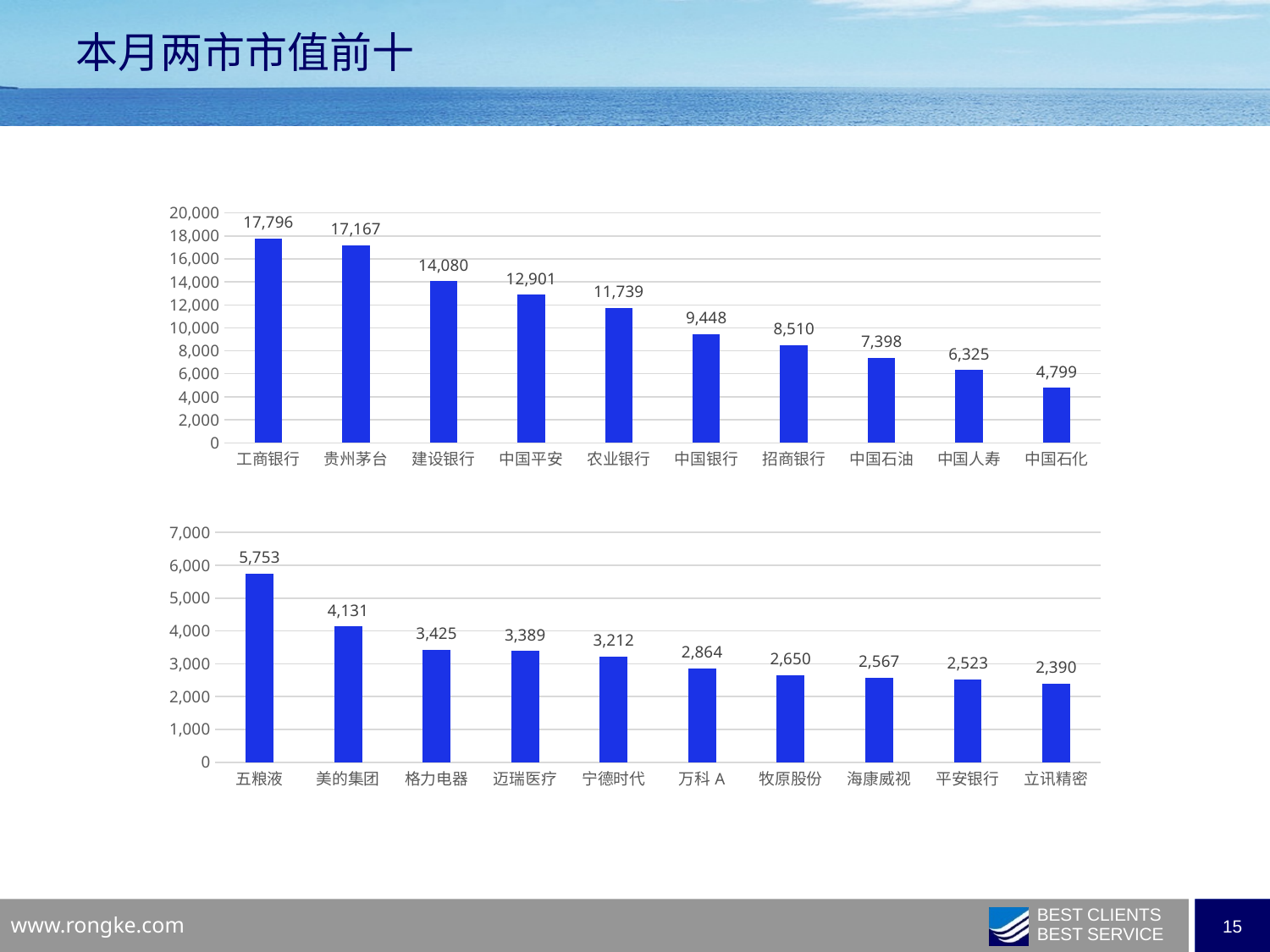
In the bottom chart, which is larger, the value for 美的集团 or the value for 格力电器? 美的集团 In the bottom chart, what is the value for 宁德时代? 3,212 In the top chart, which category has the lowest value? 中国石化 In the top chart, which category has the highest value? 工商银行 In the bottom chart, which category has the lowest value? 立讯精密 In the top chart, what is the value for 建设银行? 14,080 In the top chart, what is the difference between the values for 工商银行 and 贵州茅台? 629 What kind of chart is the bottom chart? bar chart In the top chart, do the values rise or fall from left to right? fall In the bottom chart, which category has the highest value? 五粮液 In the bottom chart, what is the difference between the values for 五粮液 and 美的集团? 1,622 In the top chart, how many categories are shown? 10